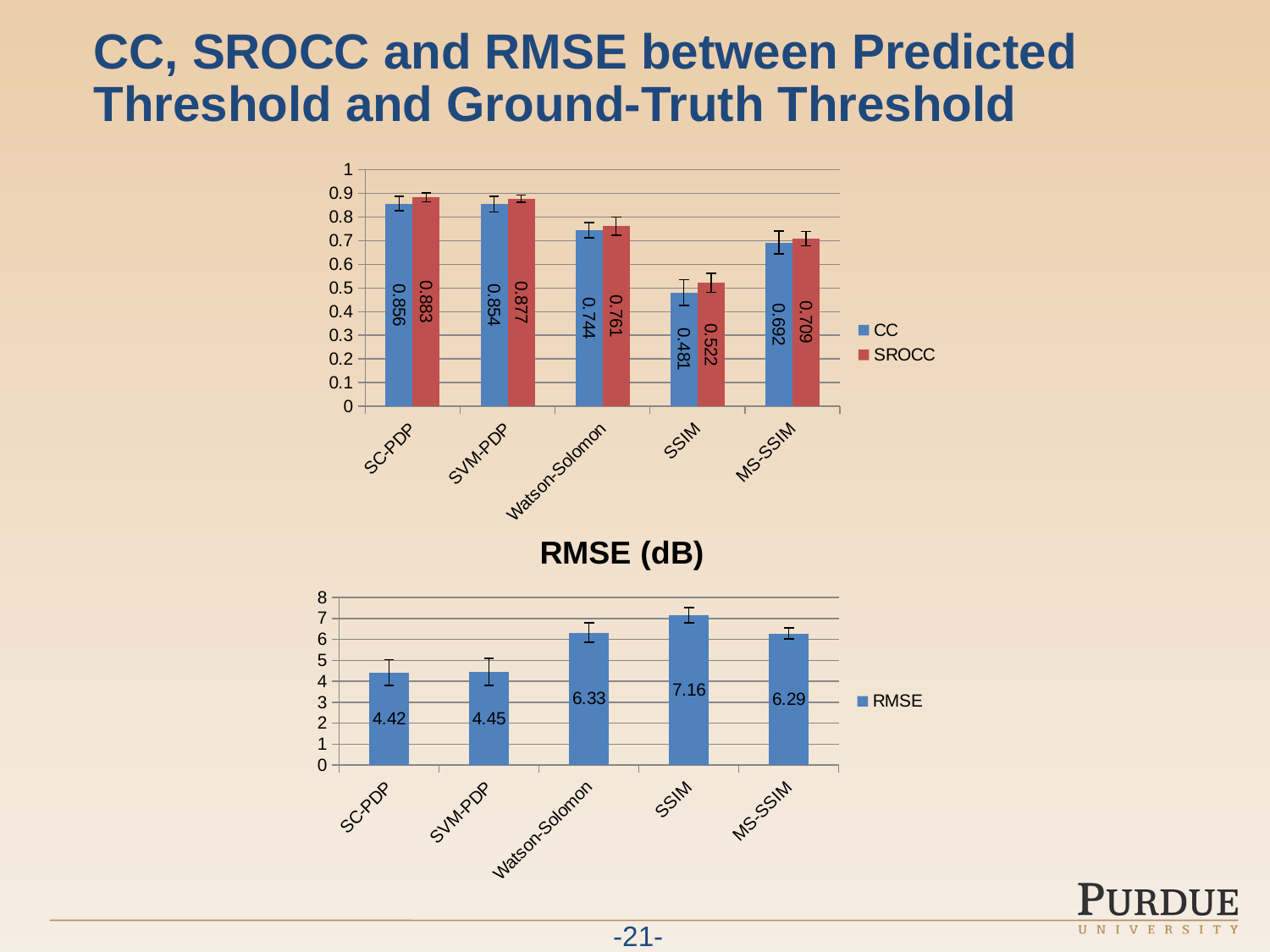
In the top chart, which category has the lowest CC value? SSIM What kind of chart is the RMSE (dB) chart? bar chart In the top chart, which category has the highest SROCC value? SC-PDP In the RMSE (dB) chart, what is the value for SSIM? 7.16 In the top chart, what is the difference between the SROCC and CC values for Watson-Solomon? 0.017 In the top chart, what is the SROCC value for SSIM? 0.522 In the RMSE (dB) chart, which category has the lowest value? SC-PDP In the top chart, is the CC value for MS-SSIM greater or less than 0.5? greater In the RMSE (dB) chart, how many categories are shown on the x axis? 5 In the top chart, what is the CC value for SC-PDP? 0.856 In the top chart, how many series does the legend list? 2 In the RMSE (dB) chart, what is the difference between the values for Watson-Solomon and SC-PDP? 1.91